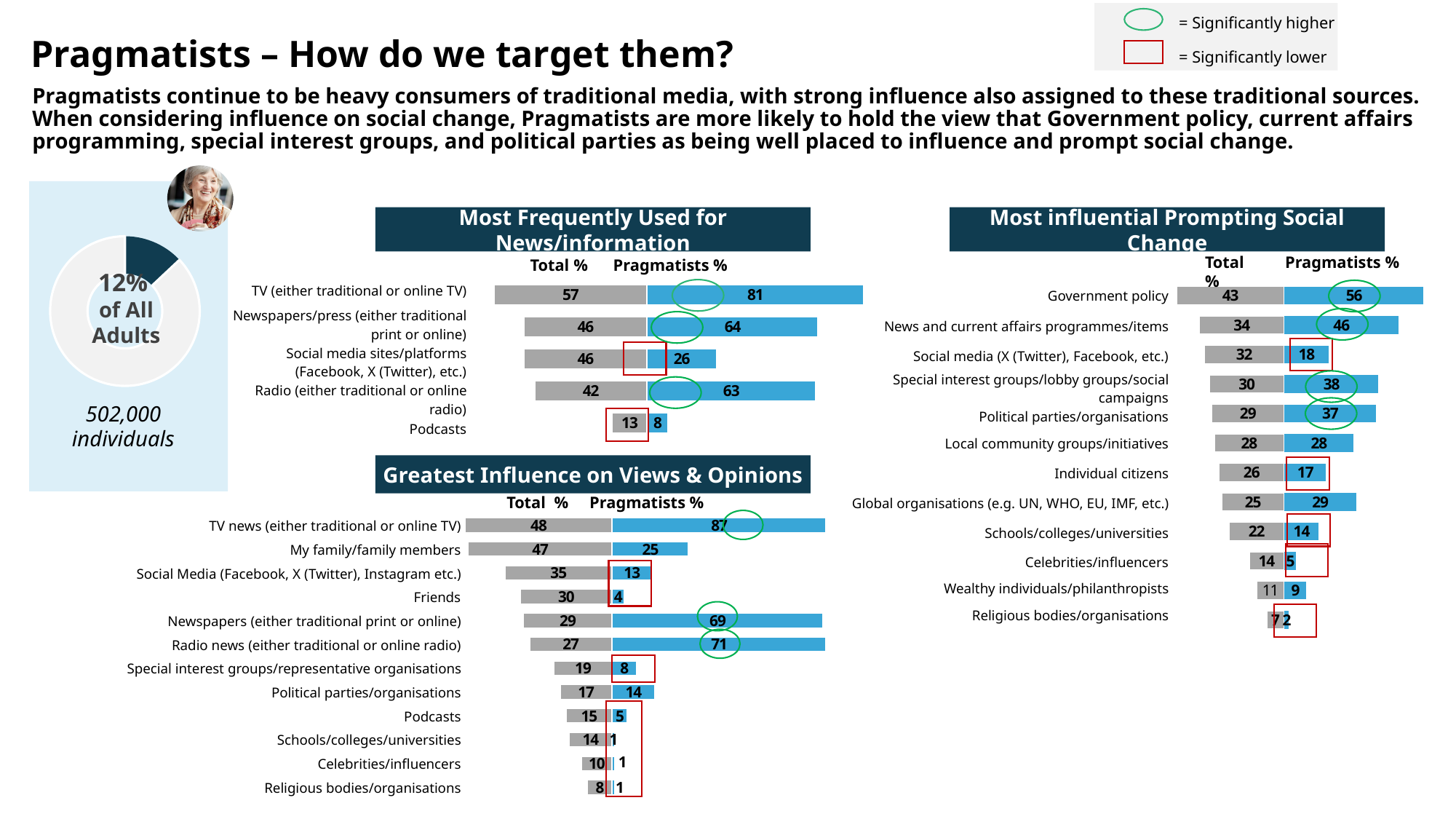
What kind of chart is used for 'Greatest Influence on Views & Opinions'? Bar chart In the 'Greatest Influence on Views & Opinions' chart, what is the Pragmatists % for Radio news (either traditional or online radio)? 71 In the 'Most Frequently Used for News/information' chart, what is the Total % for Podcasts? 13 In the 'Most influential Prompting Social Change' chart, what is the Pragmatists % for Government policy? 56 In the 'Most influential Prompting Social Change' chart, which category has the lowest Pragmatists %? Religious bodies/organisations In the 'Most Frequently Used for News/information' chart, how many categories are shown? 5 In the 'Greatest Influence on Views & Opinions' chart, how many categories are listed? 12 In the 'Greatest Influence on Views & Opinions' chart, which category has the highest Pragmatists %? TV news (either traditional or online TV) In the 'Most Frequently Used for News/information' chart, what is the Pragmatists % for TV (either traditional or online TV)? 81 In the 'Greatest Influence on Views & Opinions' chart, which is larger for Friends: the Total % or the Pragmatists %? Total % In the 'Most influential Prompting Social Change' chart, what is the difference between the Total % and the Pragmatists % for Social media (X (Twitter), Facebook, etc.)? 14 In the 'Most Frequently Used for News/information' chart, what is the difference between the Pragmatists % and the Total % for Radio (either traditional or online radio)? 21